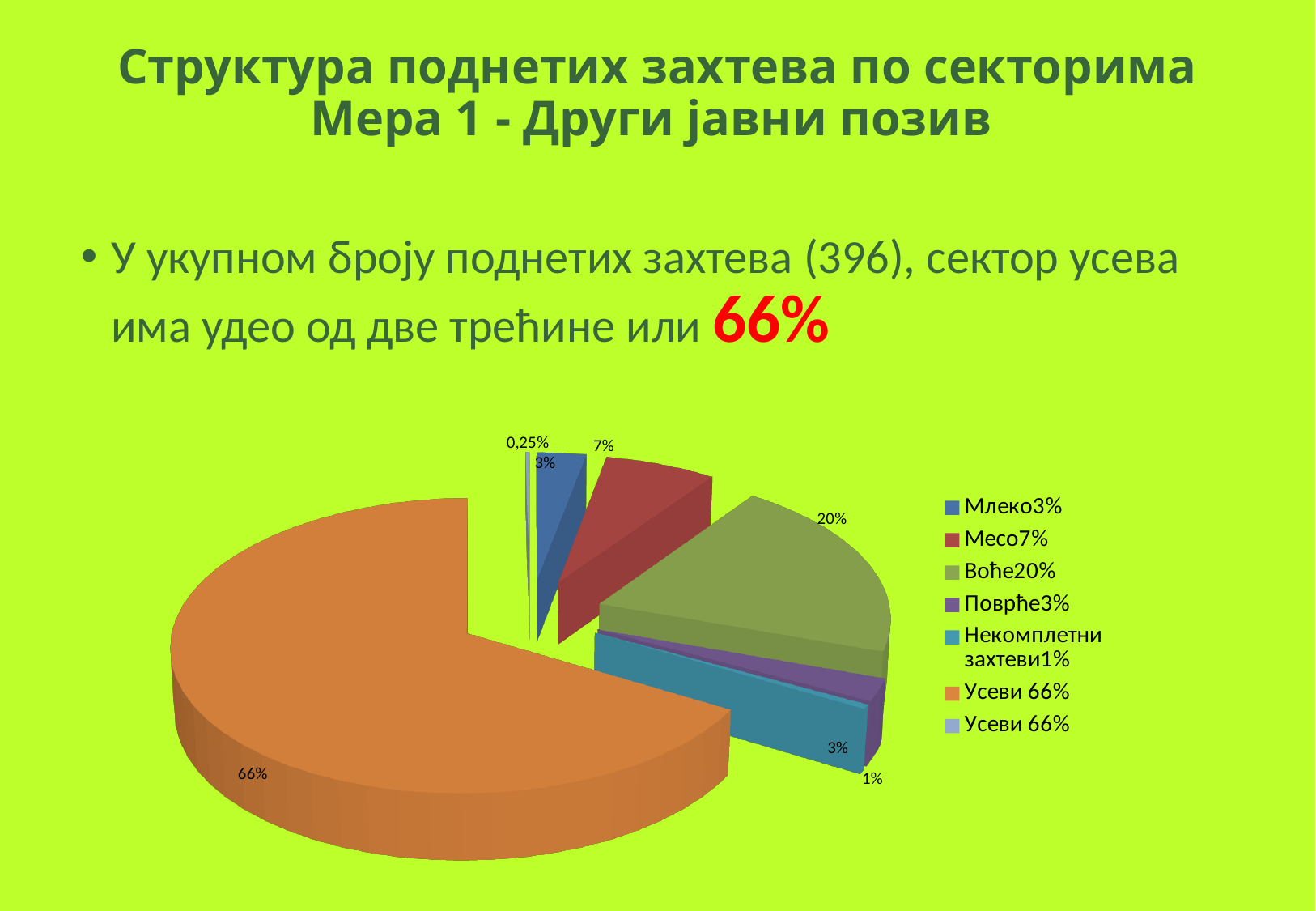
What share of the pie does Млеко have? 3% What is the smallest data label printed on the pie chart? 0,25% How many entries does the legend list? 7 What is the difference between the share for Воће and the share for Месо? 13% What share of the pie does Месо have? 7% What kind of chart is shown on the slide? pie chart What share of the pie do Некомплетни захтеви have? 1% What share of the pie does Воће have? 20% What colour is the Усеви 66% slice that makes up most of the pie? orange What is the difference between the share for Усеви and the share for Воће? 46% Which is larger, the share for Воће or the share for Месо? Воће Which category has the largest share of the pie? Усеви